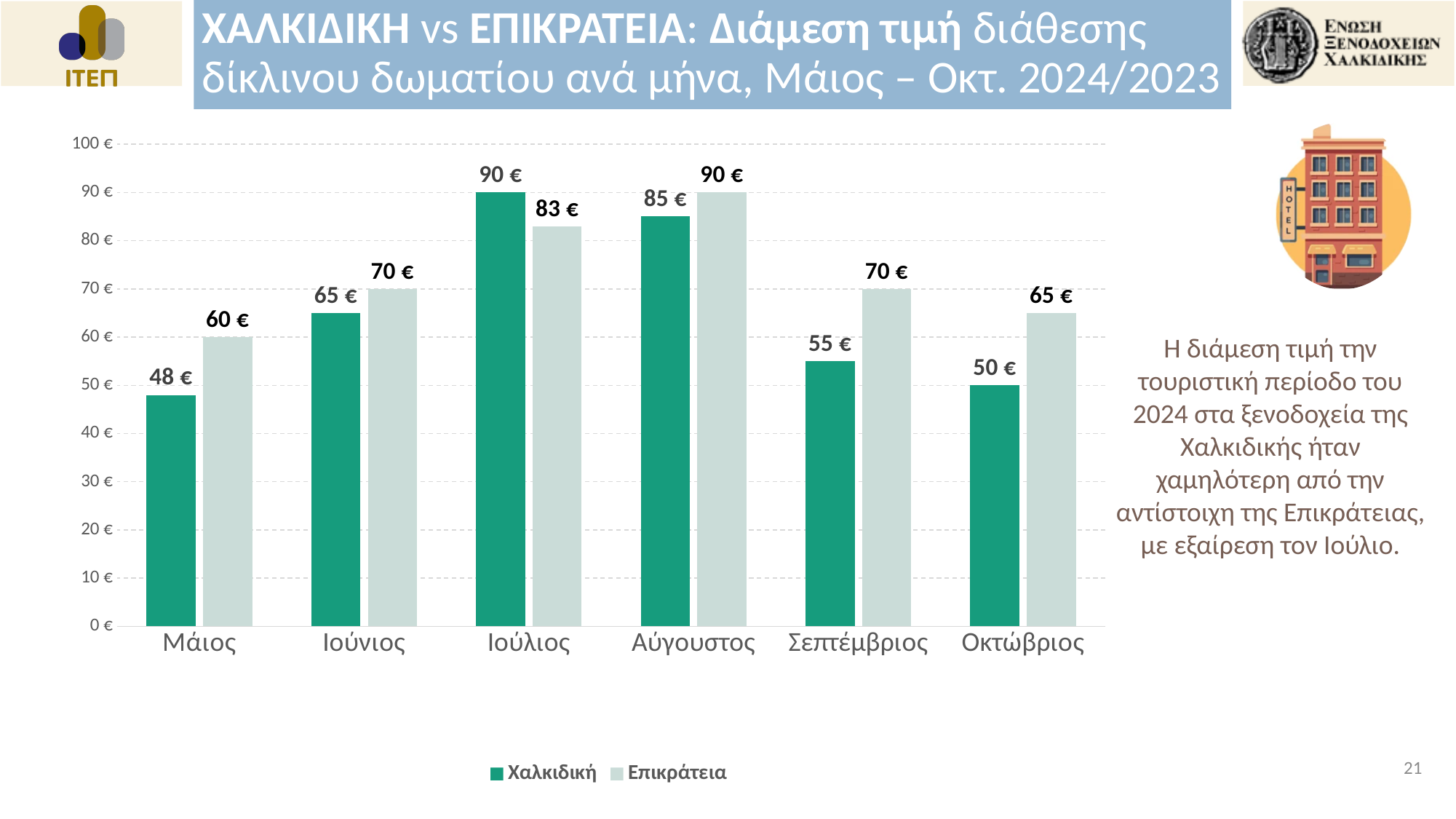
What is the value for Επικράτεια in Ιούλιος? 83 € In which month is the Επικράτεια value lowest? Μάιος What is the value for Χαλκιδική in Αύγουστος? 85 € What is the value for Επικράτεια in Οκτώβριος? 65 € How many series does the legend list? 2 In which month is the Χαλκιδική value highest? Ιούλιος Which is larger in Ιούλιος, the Χαλκιδική value or the Επικράτεια value? Χαλκιδική How many months are shown on the x axis? 6 What kind of chart is shown on the slide? Bar chart What is the difference between the Επικράτεια and Χαλκιδική values in Σεπτέμβριος? 15 € What is the value for Χαλκιδική in Μάιος? 48 € Which colour represents Χαλκιδική in the chart? Green